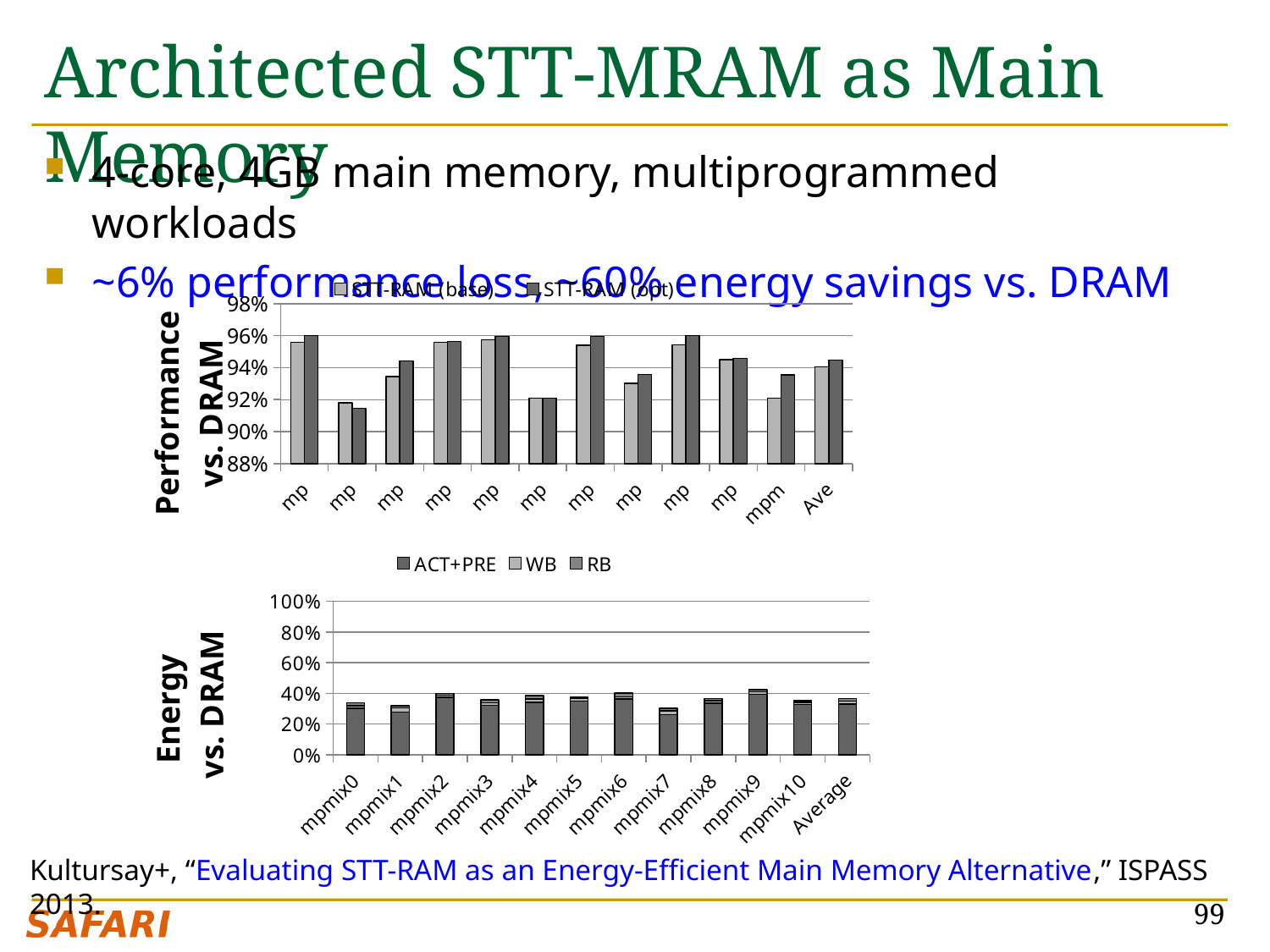
In the top chart (Performance vs. DRAM), is the STT-RAM (opt) value for Ave greater or less than 96%? less In the bottom chart (Energy vs. DRAM), is the total stacked value for mpmix9 greater or less than 60%? less In the bottom chart (Energy vs. DRAM), which has the larger total stacked value, mpmix9 or mpmix7? mpmix9 In the bottom chart (Energy vs. DRAM), is the total stacked value for mpmix7 greater or less than 40%? less How many categories are shown on the x axis of the bottom chart (Energy vs. DRAM)? 12 What kind of chart is the bottom chart (Energy vs. DRAM)? bar chart What are the legend entries of the bottom chart (Energy vs. DRAM)? ACT+PRE, WB, RB How many series does the legend of the top chart (Performance vs. DRAM) list? 2 How many series does the legend of the bottom chart (Energy vs. DRAM) list? 3 What kind of chart is the top chart (Performance vs. DRAM)? bar chart